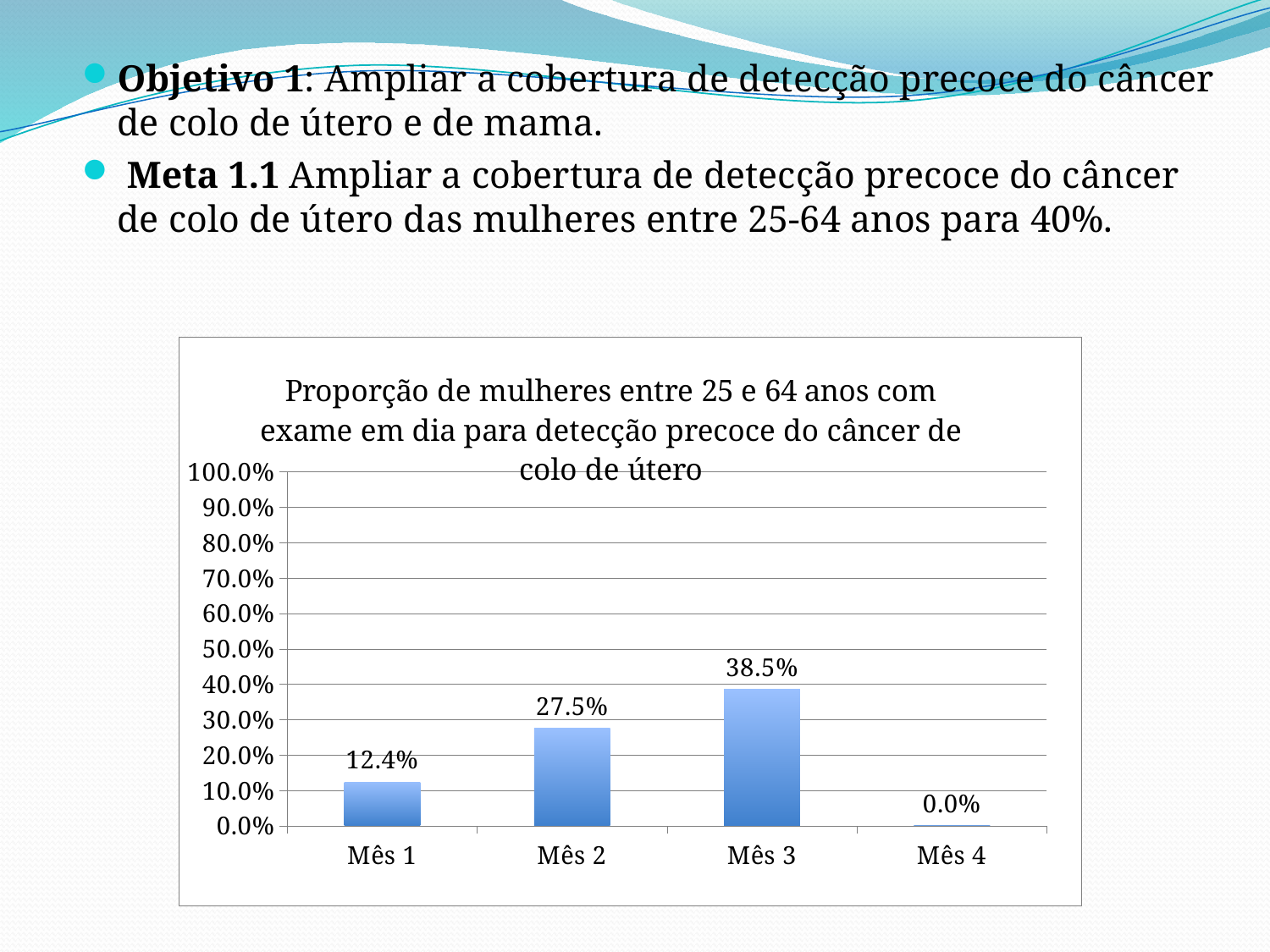
What is the difference between the values for Mês 3 and Mês 2? 11.0% What is the value for Mês 2? 27.5% Is the value for Mês 3 greater or less than 40.0%? less Which is larger, the value for Mês 1 or the value for Mês 2? Mês 2 Which month has the highest value? Mês 3 What is the title of the chart? Proporção de mulheres entre 25 e 64 anos com exame em dia para detecção precoce do câncer de colo de útero What kind of chart is shown on the slide? bar chart How many months are shown on the x axis? 4 What is the value for Mês 3? 38.5% What is the value for Mês 4? 0.0% Which month has the lowest value? Mês 4 What is the value for Mês 1? 12.4%